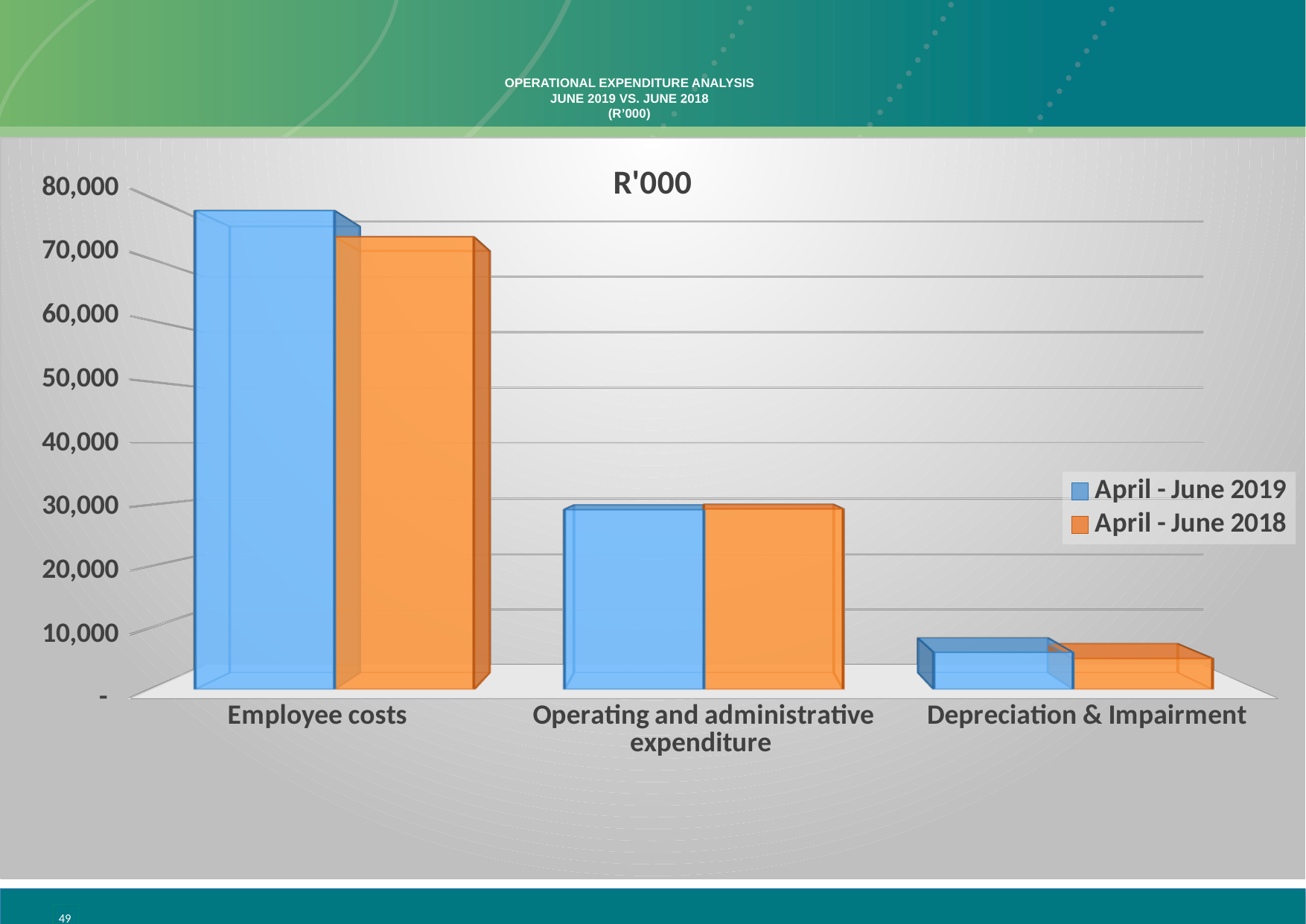
Is the April - June 2019 value for Operating and administrative expenditure greater or less than 40,000? less Is the April - June 2018 value for Depreciation & Impairment greater or less than 10,000? less What kind of chart is shown on the slide? bar chart For Depreciation & Impairment, which series is larger: April - June 2019 or April - June 2018? April - June 2019 How many expenditure categories are shown on the x axis? 3 For Employee costs, which series is larger: April - June 2019 or April - June 2018? April - June 2019 How many series does the legend list? 2 Is the April - June 2019 value for Employee costs greater or less than 70,000? greater What colour are the bars for the April - June 2018 series? orange Which category has the highest value for April - June 2019? Employee costs Which category has the lowest value for April - June 2018? Depreciation & Impairment